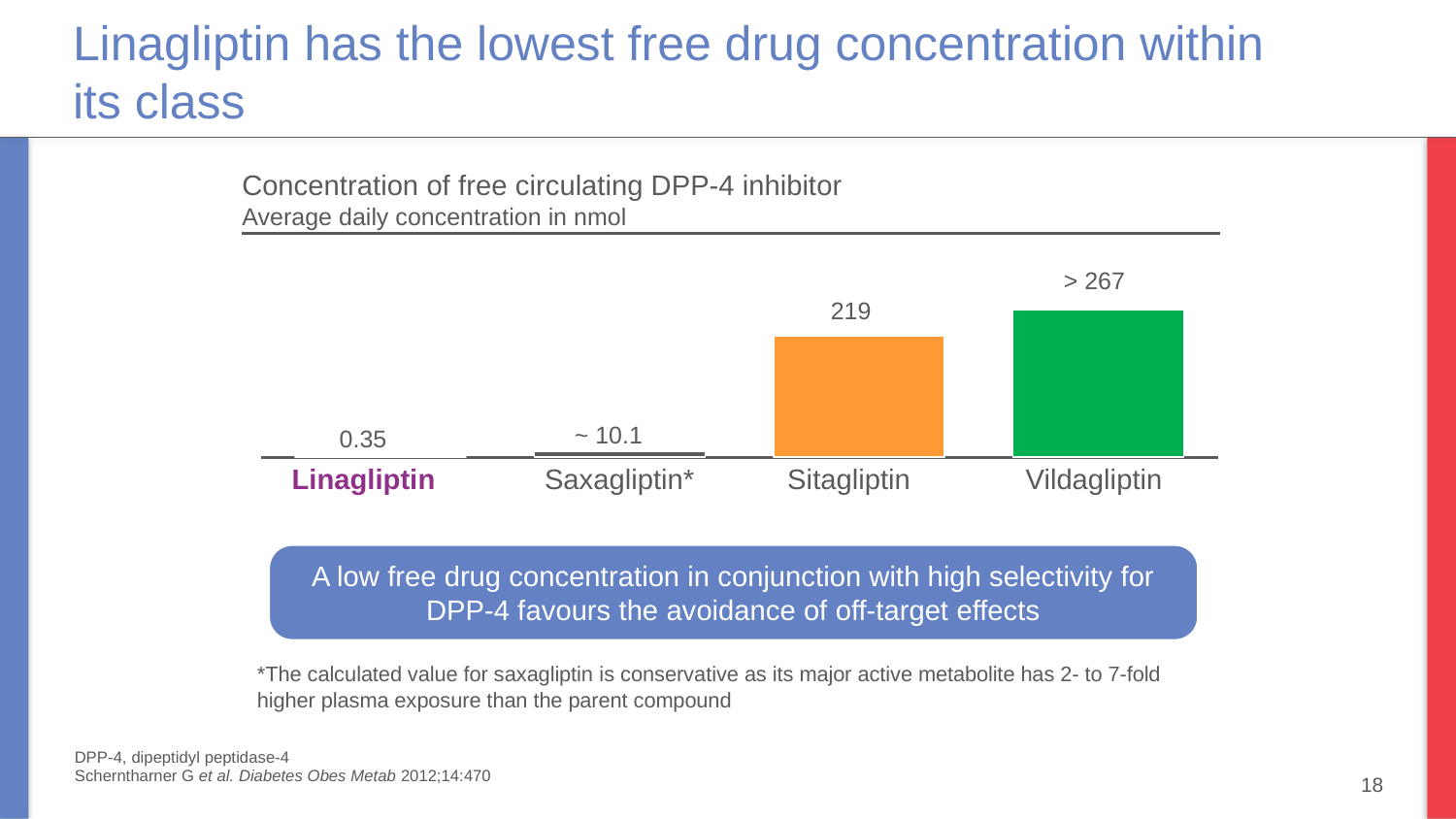
What kind of chart is shown on the slide? Bar chart Which drug has the lowest free drug concentration in the chart? Linagliptin What is the value for Sitagliptin? 219 What colour is the Sitagliptin bar? Orange What is the difference between the values for Sitagliptin and Linagliptin? 218.65 What value is labelled on the Vildagliptin bar? > 267 How many drugs are shown in the chart? 4 What is the title of the chart? Concentration of free circulating DPP-4 inhibitor What is the value for Linagliptin? 0.35 Which is larger, the value for Sitagliptin or the value for Saxagliptin*? Sitagliptin Which drug has the highest free drug concentration in the chart? Vildagliptin Do the values rise or fall from left to right across the chart? Rise